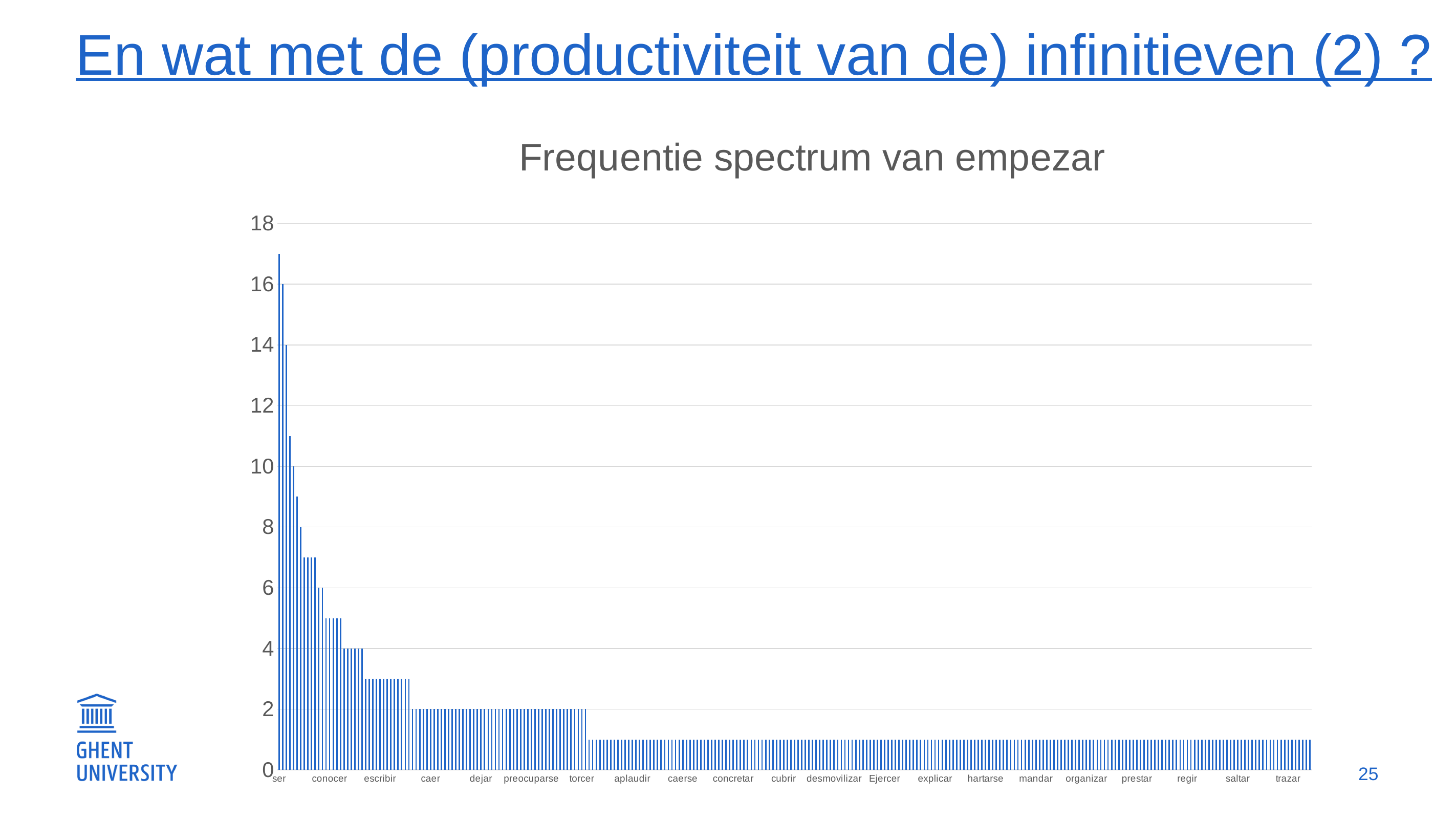
What is the title of the chart? Frequentie spectrum van empezar Which has the larger value, conocer or caer? conocer Is the value for ser greater or less than 16? greater Is the value for trazar greater or less than 2? less Is the value for escribir greater or less than 4? less Which category has the highest value in the chart? ser What is the value for dejar? 2 Do the values rise or fall from left to right along the x axis? fall What is the value for caer? 2 What kind of chart is shown on the slide? bar chart